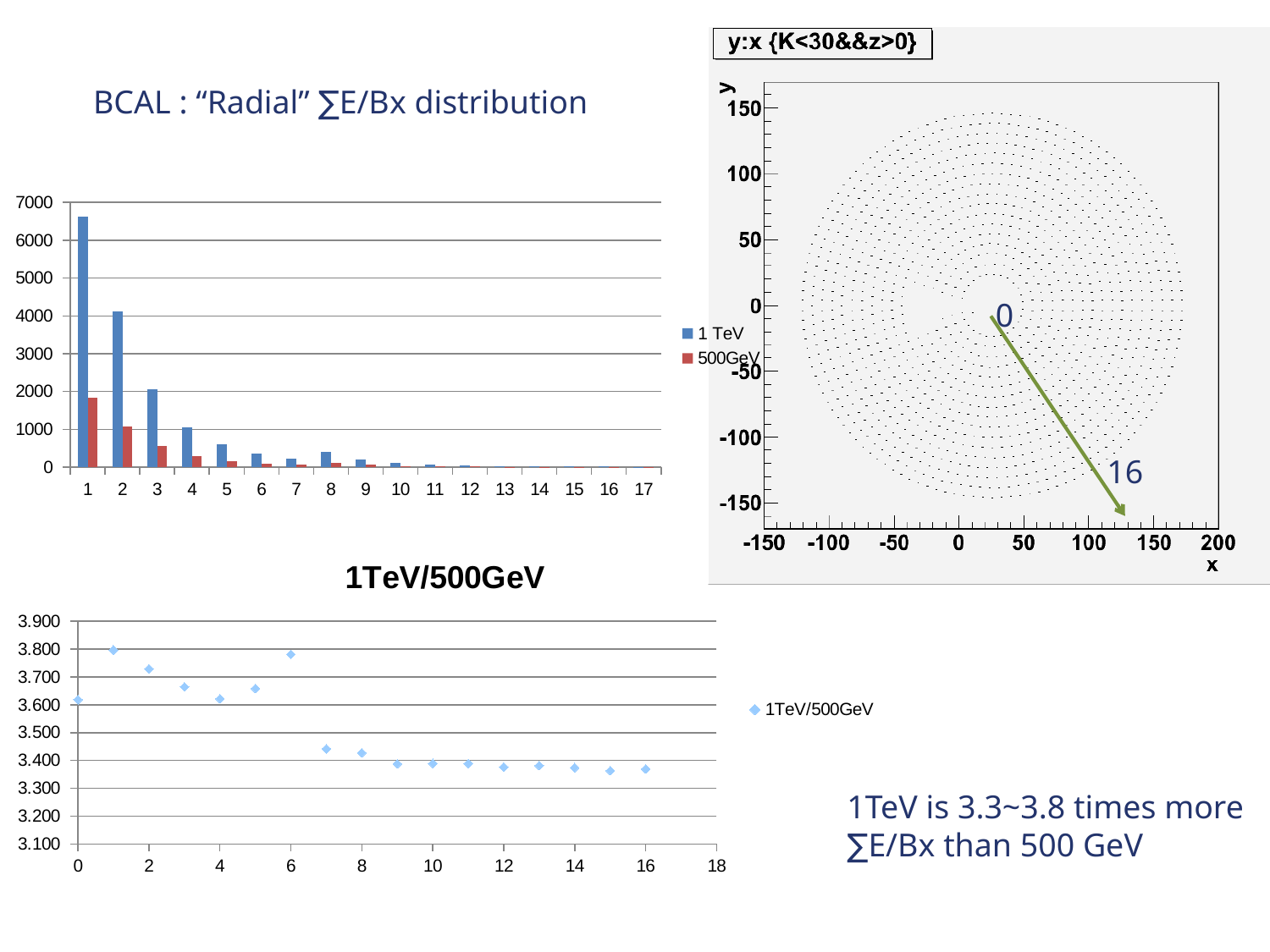
What kind of chart is the bottom chart titled "1TeV/500GeV"? scatter chart In the bottom chart titled "1TeV/500GeV", is the value at x = 10 greater or less than 3.500? less In the top-left bar chart, is the 1 TeV value for category 1 greater or less than 6000? greater In the top-left bar chart, do the 1 TeV values rise or fall as the category number increases? fall What kind of chart is the top-left chart titled "BCAL : "Radial" ∑E/Bx distribution"? bar chart In the top-left bar chart, which series is larger for category 3, 1 TeV or 500GeV? 1 TeV In the top-left bar chart, is the 500GeV value for category 1 greater or less than 2000? less In the top-left bar chart, which category has the highest 1 TeV value? 1 In the bottom chart titled "1TeV/500GeV", which is larger, the value at x = 1 or the value at x = 10? x = 1 How many categories are shown on the x axis of the top-left bar chart? 17 How many series does the legend of the top-left bar chart list? 2